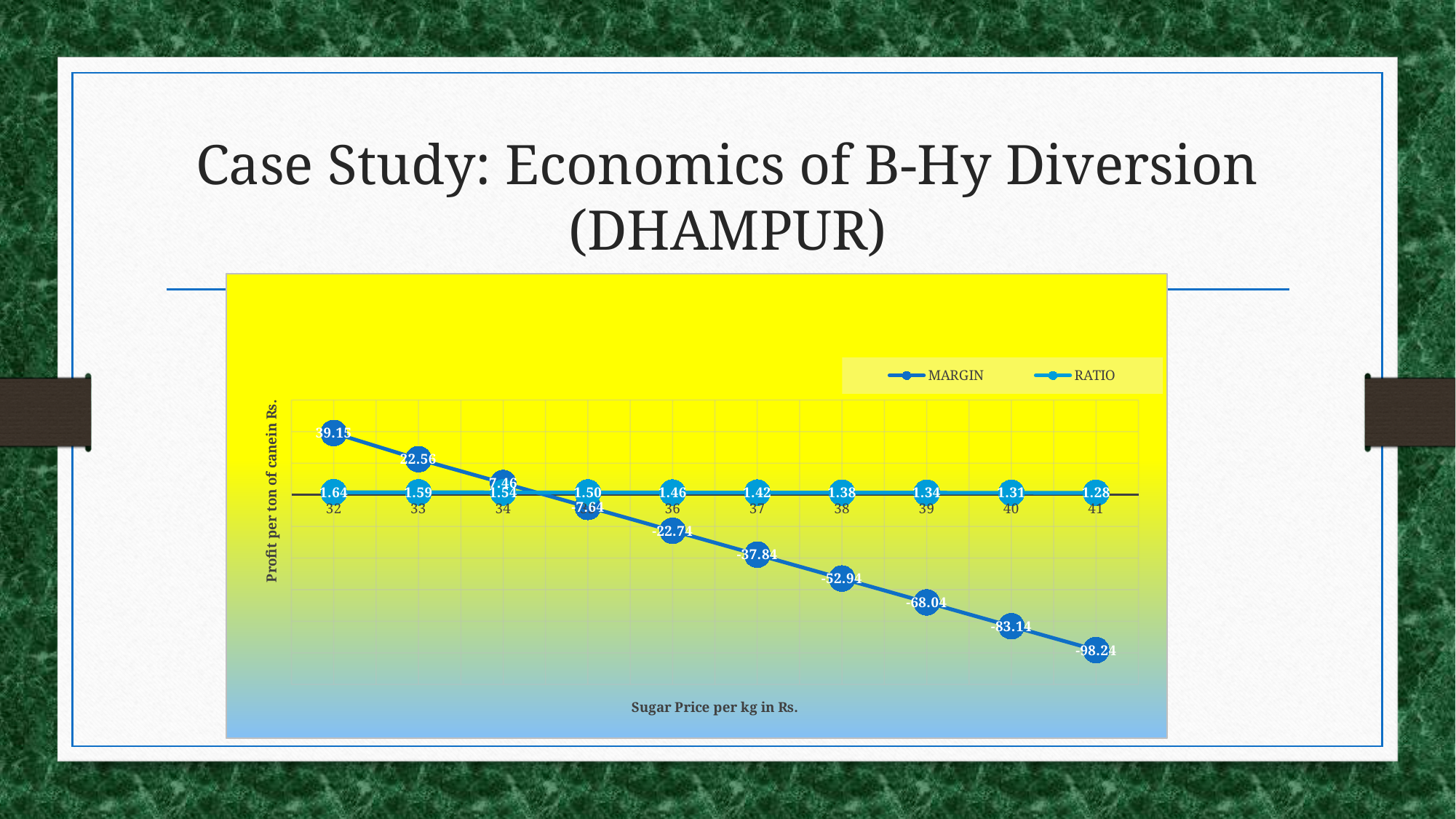
What kind of chart is shown on the slide? line chart Does the MARGIN series rise or fall as the sugar price increases from 32 to 41? fall How many sugar price points are plotted along the x axis? 10 At which sugar price is the MARGIN value lowest? 41 What is the RATIO value at a sugar price of 32? 1.64 How many series does the legend list? 2 What is the title of the x axis? Sugar Price per kg in Rs. What is the MARGIN value at a sugar price of 33? 22.56 What is the MARGIN value at a sugar price of 41? -98.24 What is the RATIO value at a sugar price of 38? 1.38 What is the difference between the RATIO value at sugar price 32 and at sugar price 41? 0.36 Which sugar price has the larger MARGIN value, 36 or 37? 36